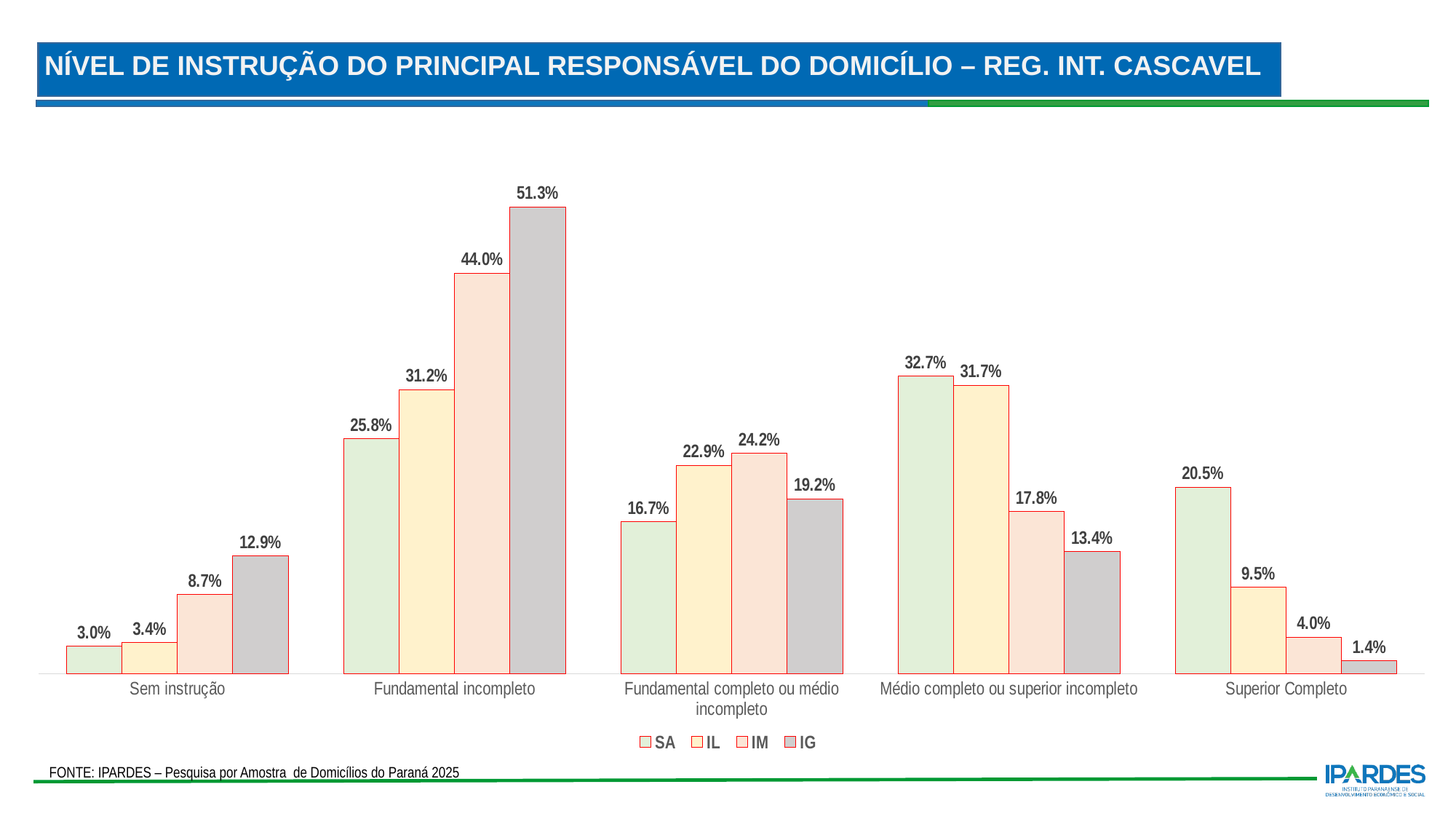
What kind of chart is shown on the slide? Bar chart What is the title of the chart? NÍVEL DE INSTRUÇÃO DO PRINCIPAL RESPONSÁVEL DO DOMICÍLIO – REG. INT. CASCAVEL What is the value for IM in the "Sem instrução" category? 8.7% What is the value for IG in the "Fundamental incompleto" category? 51.3% Do the values for the IG series rise or fall from "Fundamental incompleto" to "Superior Completo"? Fall Which category has the highest value for the IG series? Fundamental incompleto What is the value for SA in the "Superior Completo" category? 20.5% Which category has the lowest value for the SA series? Sem instrução In the "Superior Completo" category, which series has the larger value, IL or IM? IL How many series does the legend list? 4 How many categories are shown on the x axis? 5 What is the difference between the IM and SA values in the "Fundamental incompleto" category? 18.2%